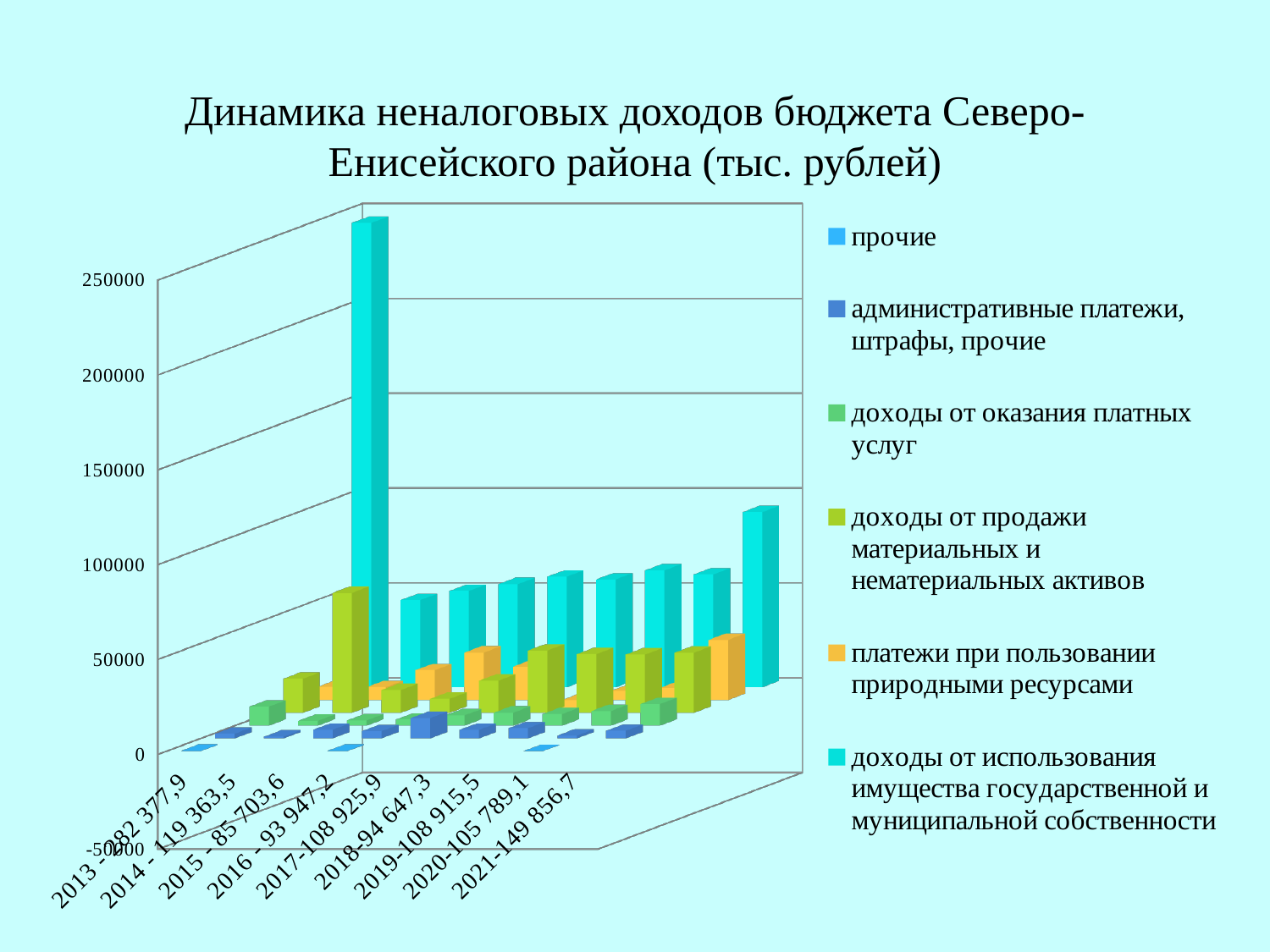
What colour represents 'прочие' in the legend? light blue Is the tallest bar for 'доходы от использования имущества государственной и муниципальной собственности' greater or less than 200000? greater For 'доходы от использования имущества государственной и муниципальной собственности', which is larger: the 2021 bar or the 2018 bar? 2021 Is the value for 'доходы от использования имущества государственной и муниципальной собственности' in 2021 greater or less than 50000? greater What kind of chart is shown on the slide? bar chart How many year categories are shown on the x axis? 9 How many series does the legend list? 6 Which series has the lowest bars across the chart? прочие Which series has the tallest bar in the chart? доходы от использования имущества государственной и муниципальной собственности In 2021, which is larger: 'доходы от использования имущества государственной и муниципальной собственности' or 'платежи при пользовании природными ресурсами'? доходы от использования имущества государственной и муниципальной собственности What is the highest value shown on the vertical axis? 250000